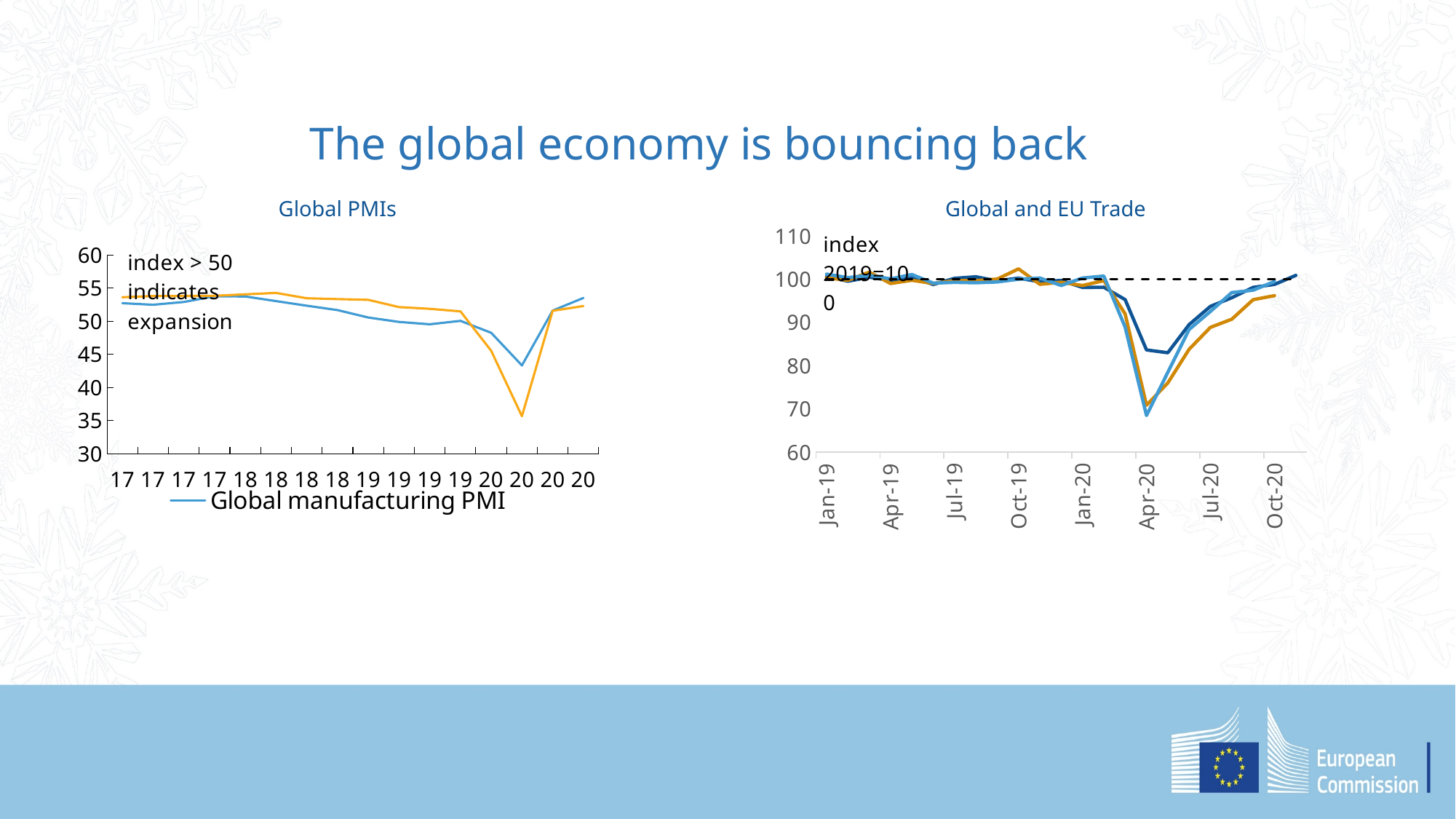
In the "Global and EU Trade" chart, do the lines rise or fall between Apr-20 and Oct-20? rise What kind of chart is the "Global PMIs" chart? line chart In the "Global PMIs" chart, is the last value of the Global manufacturing PMI line greater or less than 50? greater What kind of chart is the "Global and EU Trade" chart? line chart In the "Global and EU Trade" chart, at what level is the horizontal dashed line drawn? 100 In the "Global and EU Trade" chart, is the lowest value of the light blue line around Apr-20 greater or less than 80? less In the "Global PMIs" chart, is the lowest value of the blue Global manufacturing PMI line greater or less than 40? greater In the "Global PMIs" chart, which line reaches a lower minimum in 2020, the blue line or the orange line? the orange line In the "Global PMIs" chart, what series name is shown in the legend? Global manufacturing PMI In the "Global PMIs" chart, how many series does the legend list? 1